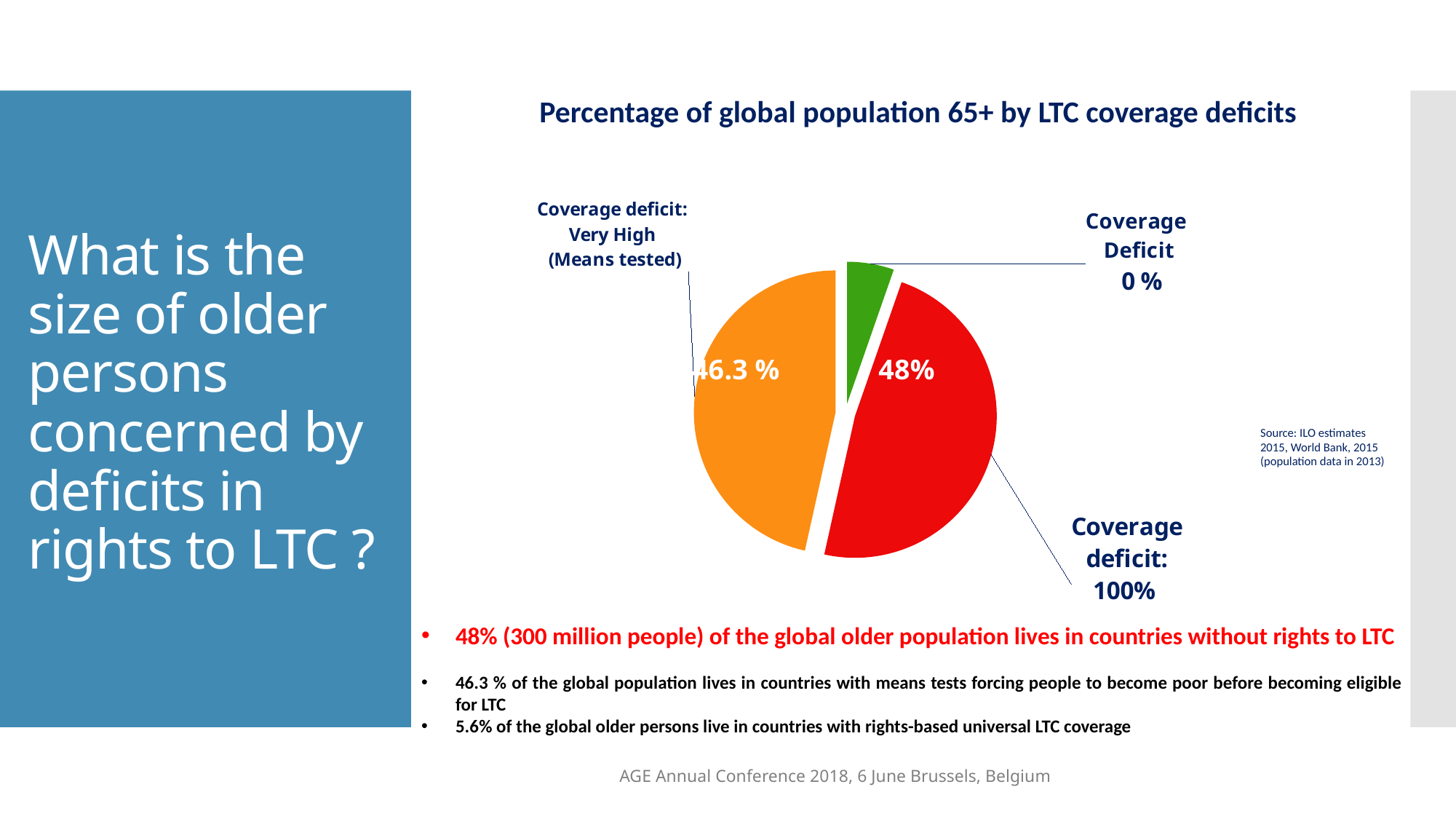
What is the difference between the 'Coverage deficit: 100%' slice (48%) and the 'Coverage deficit: Very High (Means tested)' slice (46.3 %)? 1.7% What percentage is shown for the 'Coverage deficit: 100%' slice? 48% Which slice of the pie is the smallest? Coverage Deficit 0 % What kind of chart is shown on the slide? pie chart What percentage is shown for the 'Coverage deficit: Very High (Means tested)' slice? 46.3 % What colour is the 'Coverage deficit: 100%' slice? red Which is larger: the 'Coverage deficit: 100%' slice or the 'Coverage deficit: Very High (Means tested)' slice? Coverage deficit: 100% What is the title of the chart? Percentage of global population 65+ by LTC coverage deficits What share of the pie does the 'Coverage deficit: 100%' slice represent? 48% How many slices does the pie chart have? 3 Which slice of the pie is the largest? Coverage deficit: 100%